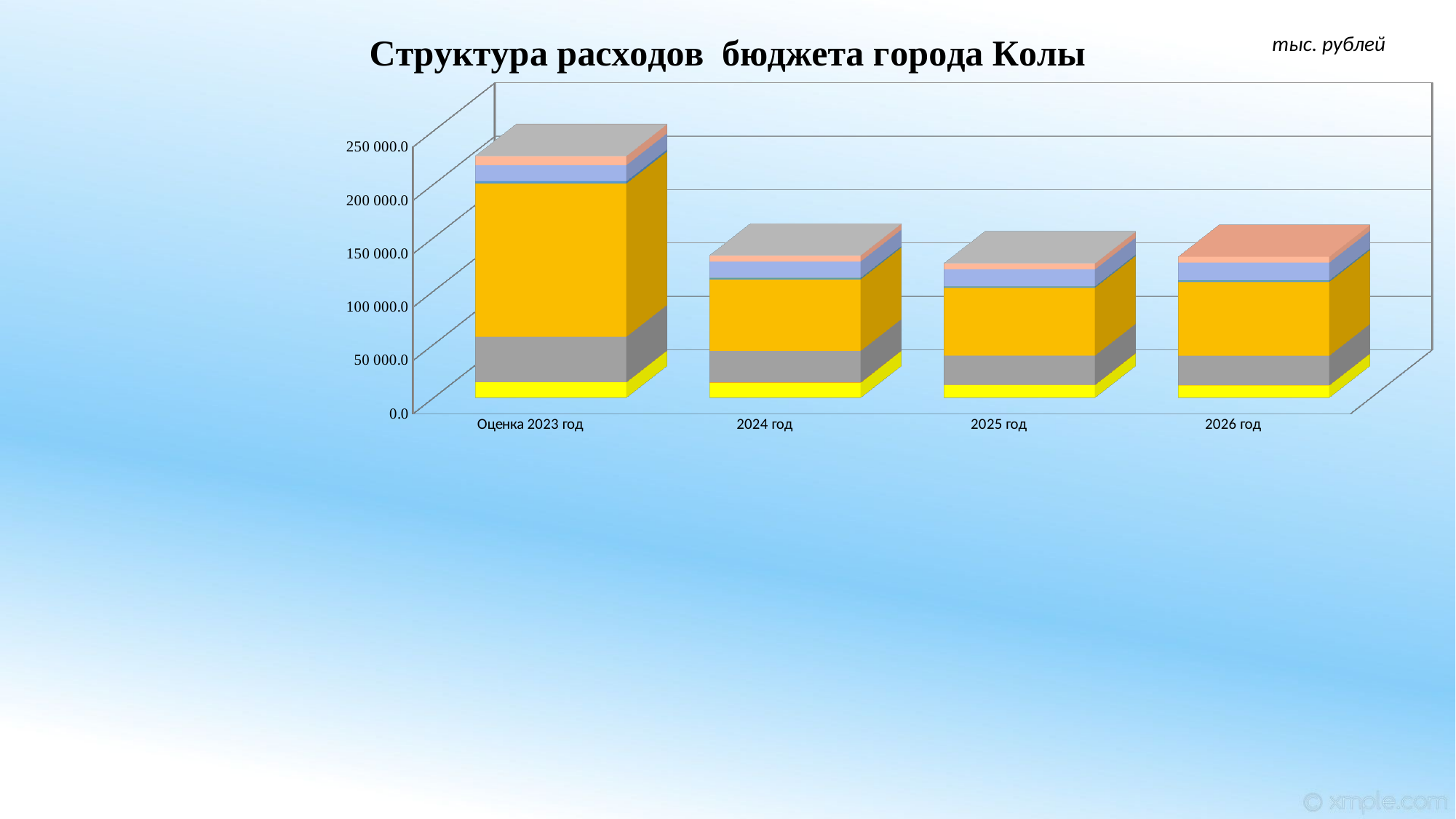
Is the total for 2024 год greater or less than 200 000.0? less Which is larger, the total for Оценка 2023 год or the total for 2024 год? Оценка 2023 год Does the total rise or fall from Оценка 2023 год to 2024 год? fall Is the total for Оценка 2023 год greater or less than 200 000.0? greater What is the title of the chart? Структура расходов бюджета города Колы Which category has the tallest stacked bar? Оценка 2023 год Is the total for 2026 год greater or less than 100 000.0? greater In what units are the values on the chart expressed? тыс. рублей How many categories are shown along the x axis? 4 What kind of chart is shown on the slide? Stacked bar chart